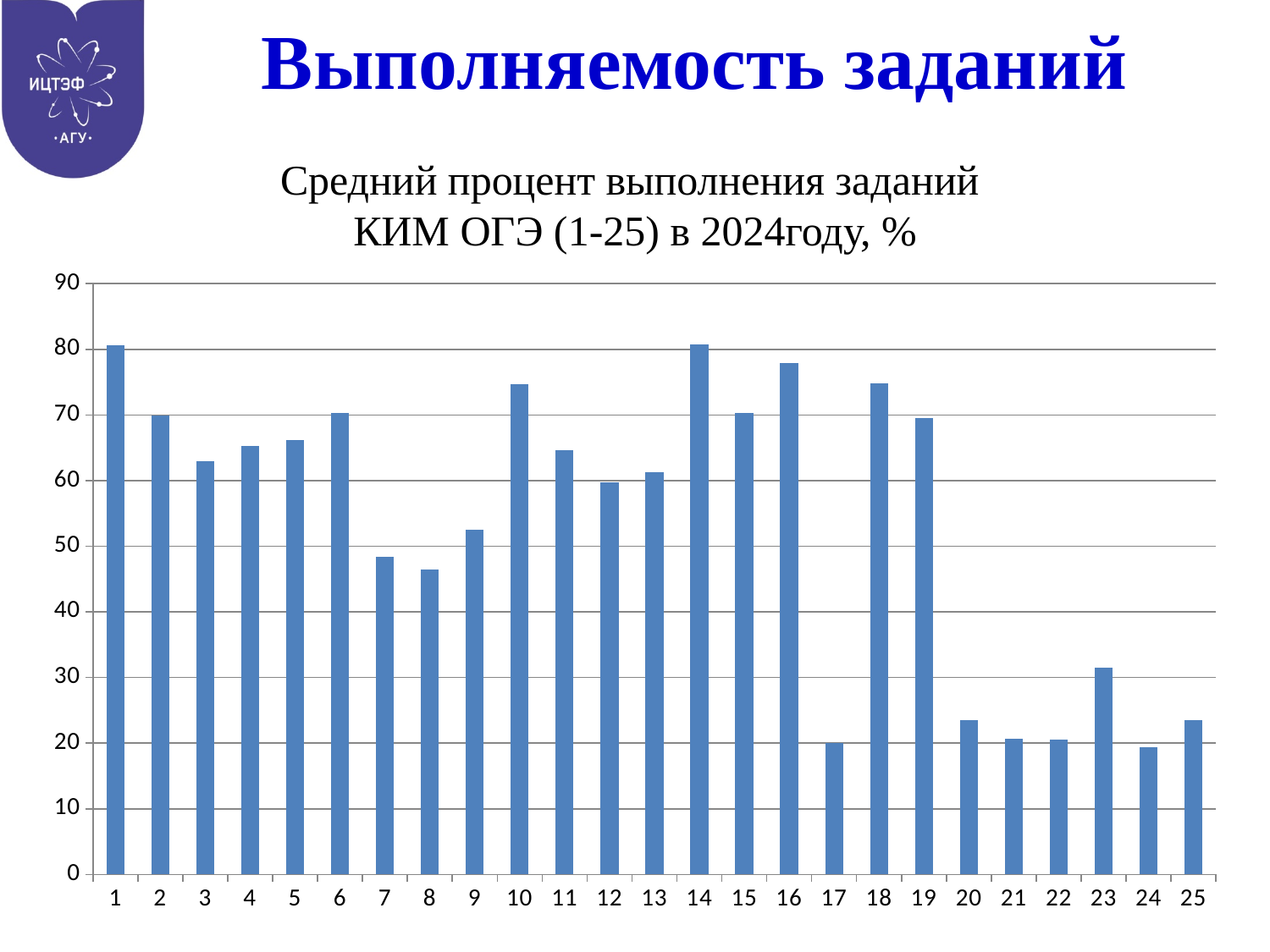
Which has the larger value, task 16 or task 17? task 16 Is the value for task 8 greater or less than 50? less Is the value for task 16 greater or less than 70? greater What is the highest value shown on the y axis? 90 Is the value for task 18 greater or less than 70? greater What kind of chart is shown on the slide? bar chart How many tasks (categories) are plotted on the x axis? 25 Which has the larger value, task 23 or task 22? task 23 Do the values rise or fall from task 19 to task 20? fall